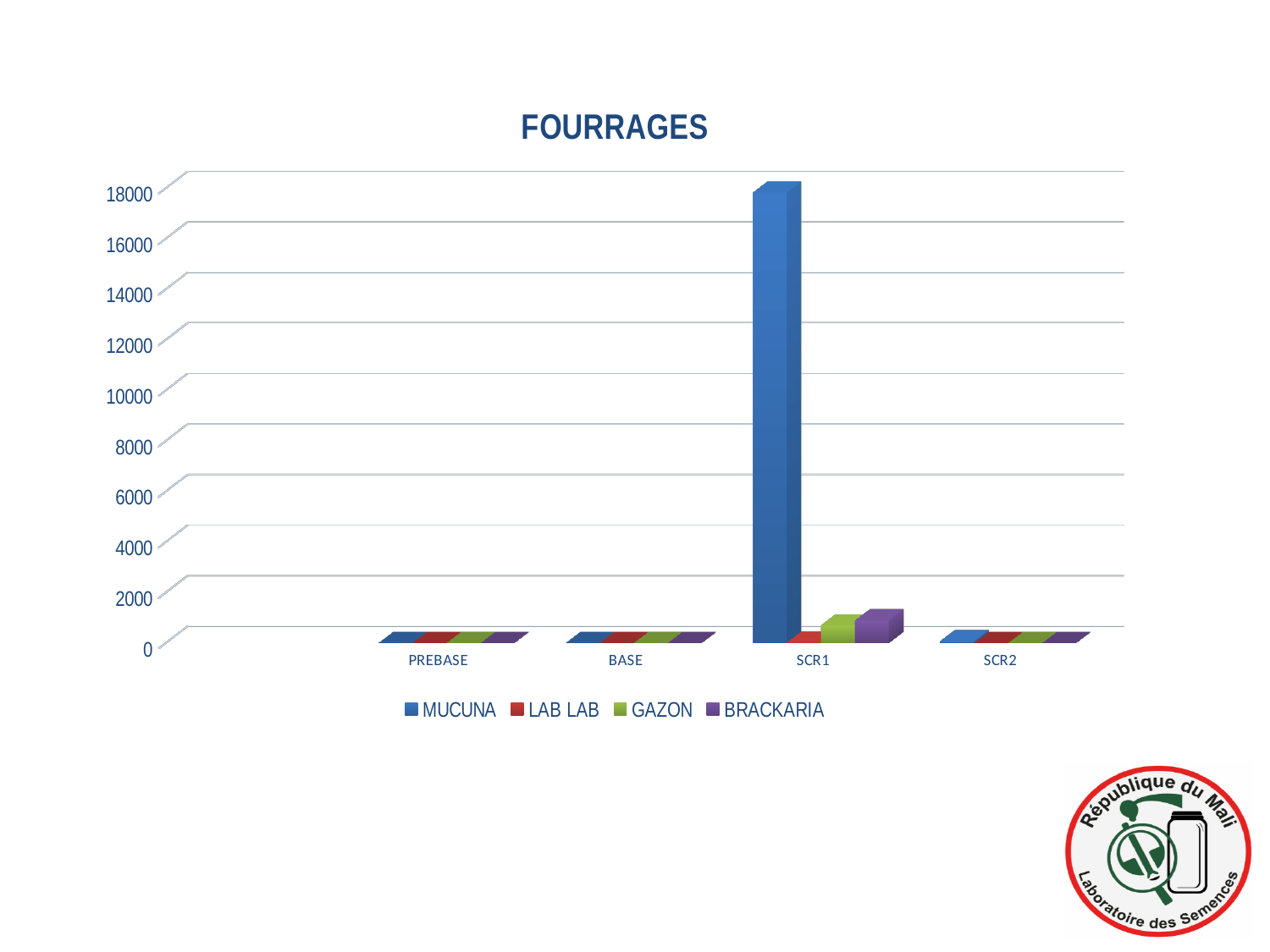
Which category has the highest value for MUCUNA? SCR1 What is the title of the chart? FOURRAGES How many series does the legend list? 4 At SCR1, which is larger: the value for MUCUNA or the value for GAZON? MUCUNA How many categories are shown on the x axis? 4 Is the value for BRACKARIA at SCR1 greater or less than 2000? less Is the value for LAB LAB at BASE greater or less than 2000? less Is the value for MUCUNA at SCR2 greater or less than 2000? less Which category has the tallest bar overall in the chart? SCR1 What kind of chart is shown on the slide? bar chart Which series is shown in purple in the legend? BRACKARIA